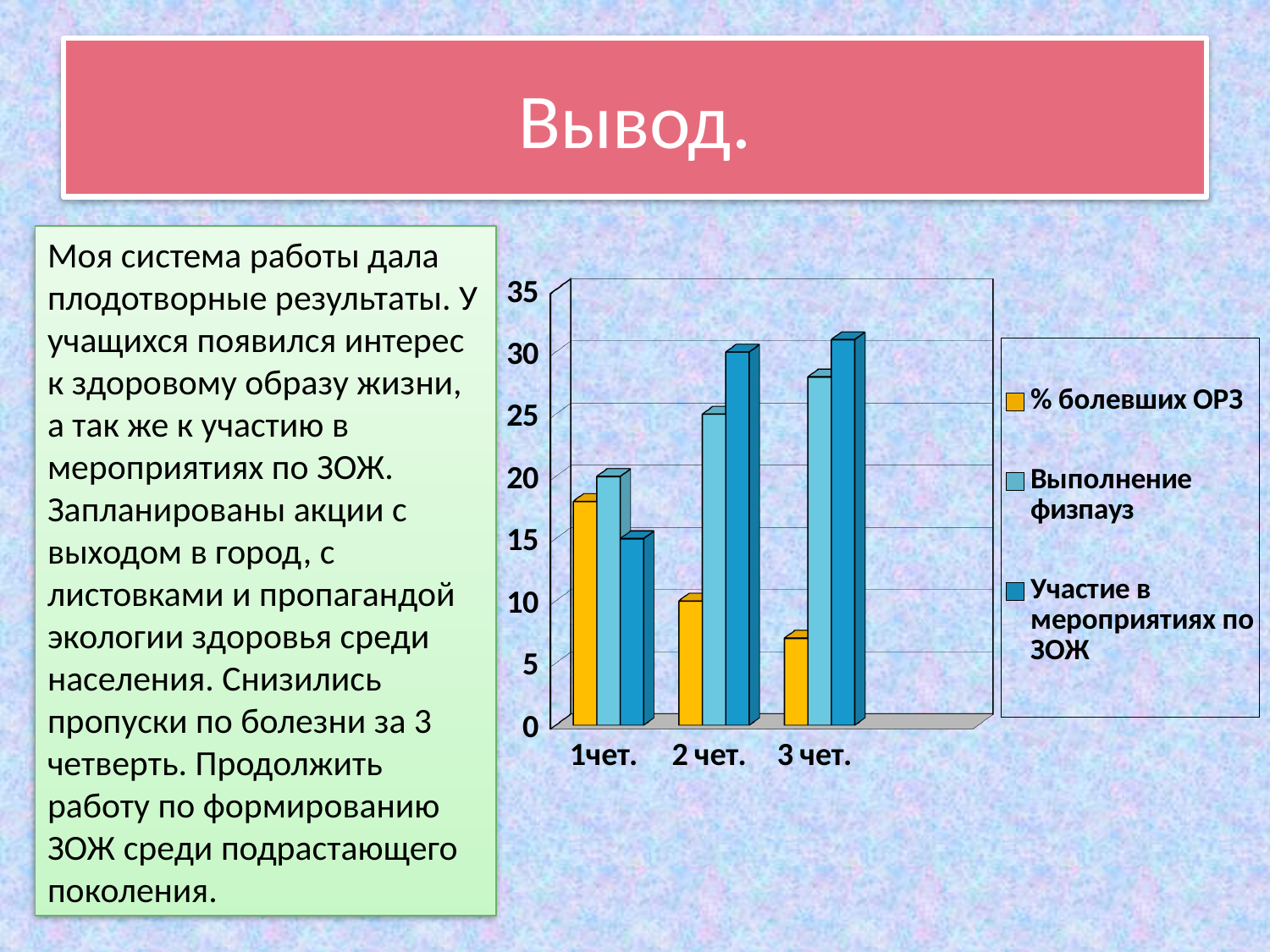
How many categories are shown on the x axis of the chart? 3 Is the value for % болевших ОРЗ in 3 чет. greater or less than 10? less Is the value for Выполнение физпауз in 3 чет. greater or less than 25? greater Which series is shown in orange in the chart legend? % болевших ОРЗ In which category is the value for Участие в мероприятиях по ЗОЖ highest? 3 чет. How many series does the chart legend list? 3 In 2 чет., which is larger: % болевших ОРЗ or Участие в мероприятиях по ЗОЖ? Участие в мероприятиях по ЗОЖ Does the value for Участие в мероприятиях по ЗОЖ rise or fall from 1чет. to 3 чет.? rise What kind of chart is shown on the slide? bar chart Does the value for % болевших ОРЗ rise or fall from 1чет. to 3 чет.? fall In which category is the value for % болевших ОРЗ lowest? 3 чет. In 1чет., which is larger: Выполнение физпауз or Участие в мероприятиях по ЗОЖ? Выполнение физпауз